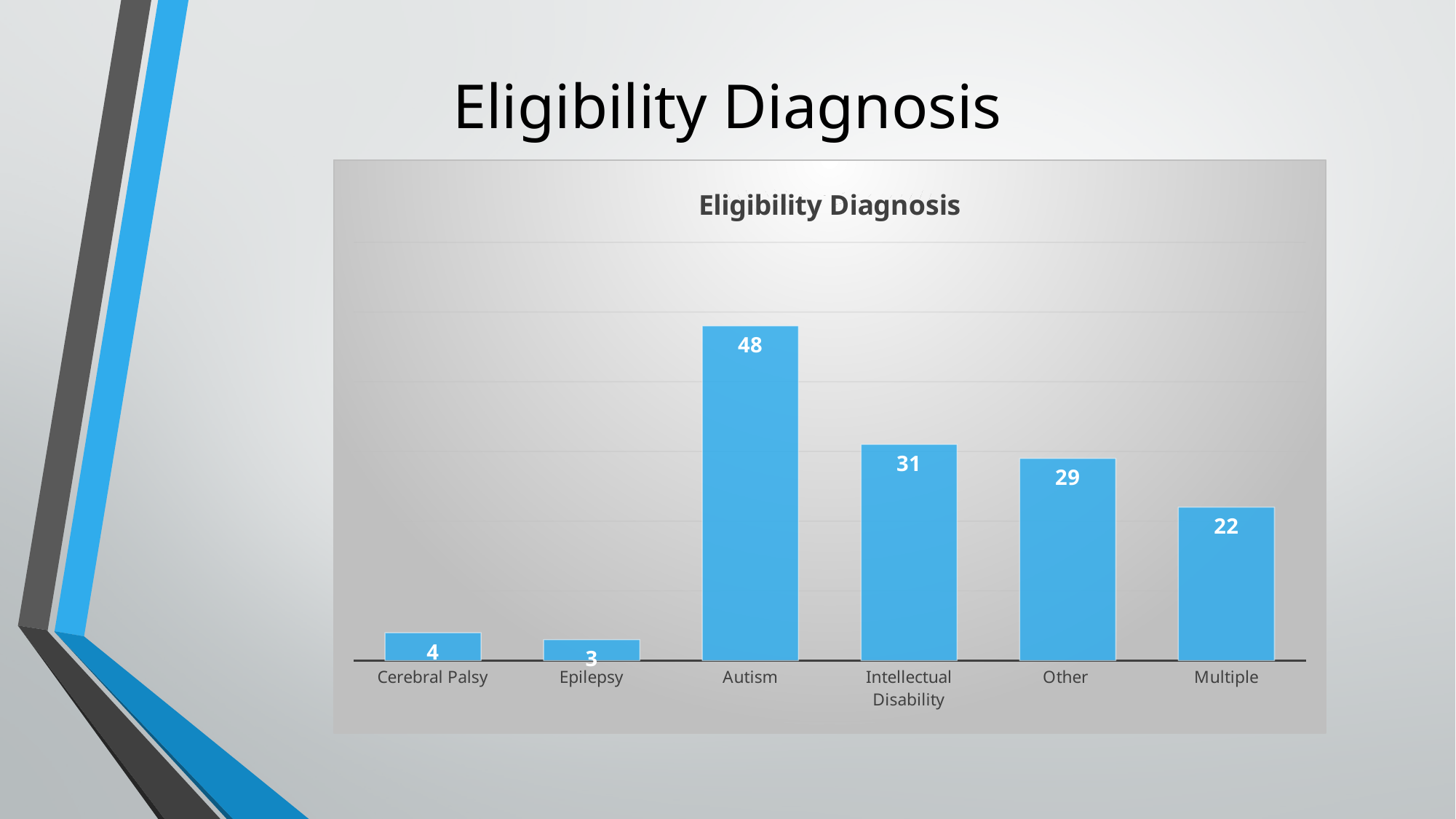
Which category has the lowest value? Epilepsy What is the title of the chart? Eligibility Diagnosis What is the value for Epilepsy? 3 What is the value for Autism? 48 What is the difference between the values for Other and Multiple? 7 Which category has the highest value? Autism What is the value for Intellectual Disability? 31 How many categories are shown on the x axis? 6 What is the difference between the values for Autism and Intellectual Disability? 17 What is the value for Multiple? 22 Which is larger, the value for Cerebral Palsy or the value for Epilepsy? Cerebral Palsy What kind of chart is shown on the slide? Bar chart